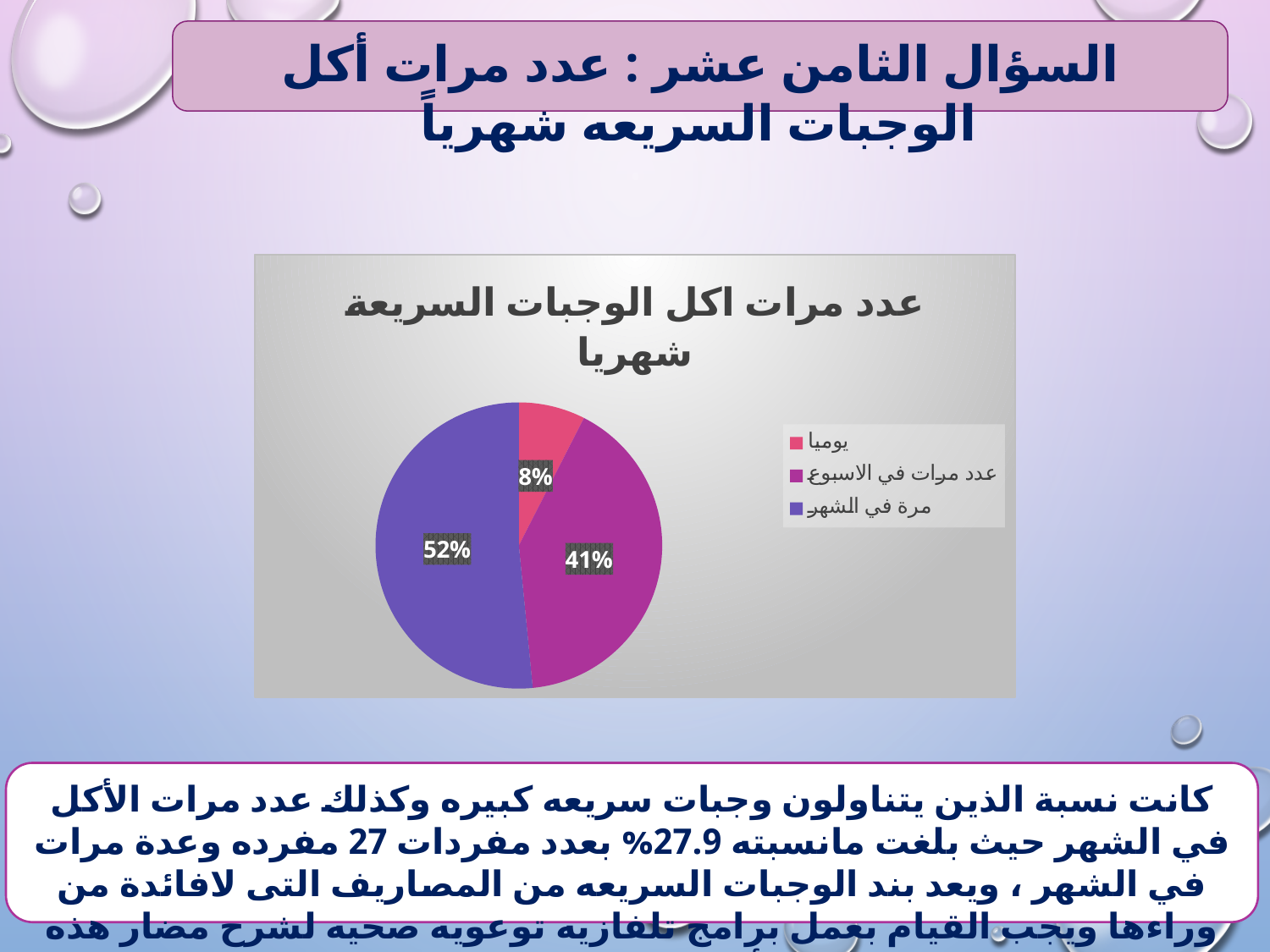
Which is larger, the share for عدد مرات في الاسبوع or the share for مرة في الشهر? مرة في الشهر What is the title of the chart? عدد مرات اكل الوجبات السريعة شهريا Which category has the largest share of the pie? مرة في الشهر What is the difference in percentage points between مرة في الشهر and عدد مرات في الاسبوع? 11 What percentage is shown for عدد مرات في الاسبوع? 41% What percentage is shown for مرة في الشهر? 52% What kind of chart is shown on the slide? pie chart How many entries does the chart legend list? 3 What percentage is shown for يوميا? 8% Which category has the smallest share of the pie? يوميا How many slices does the pie chart have? 3 What colour is the slice for يوميا? pink